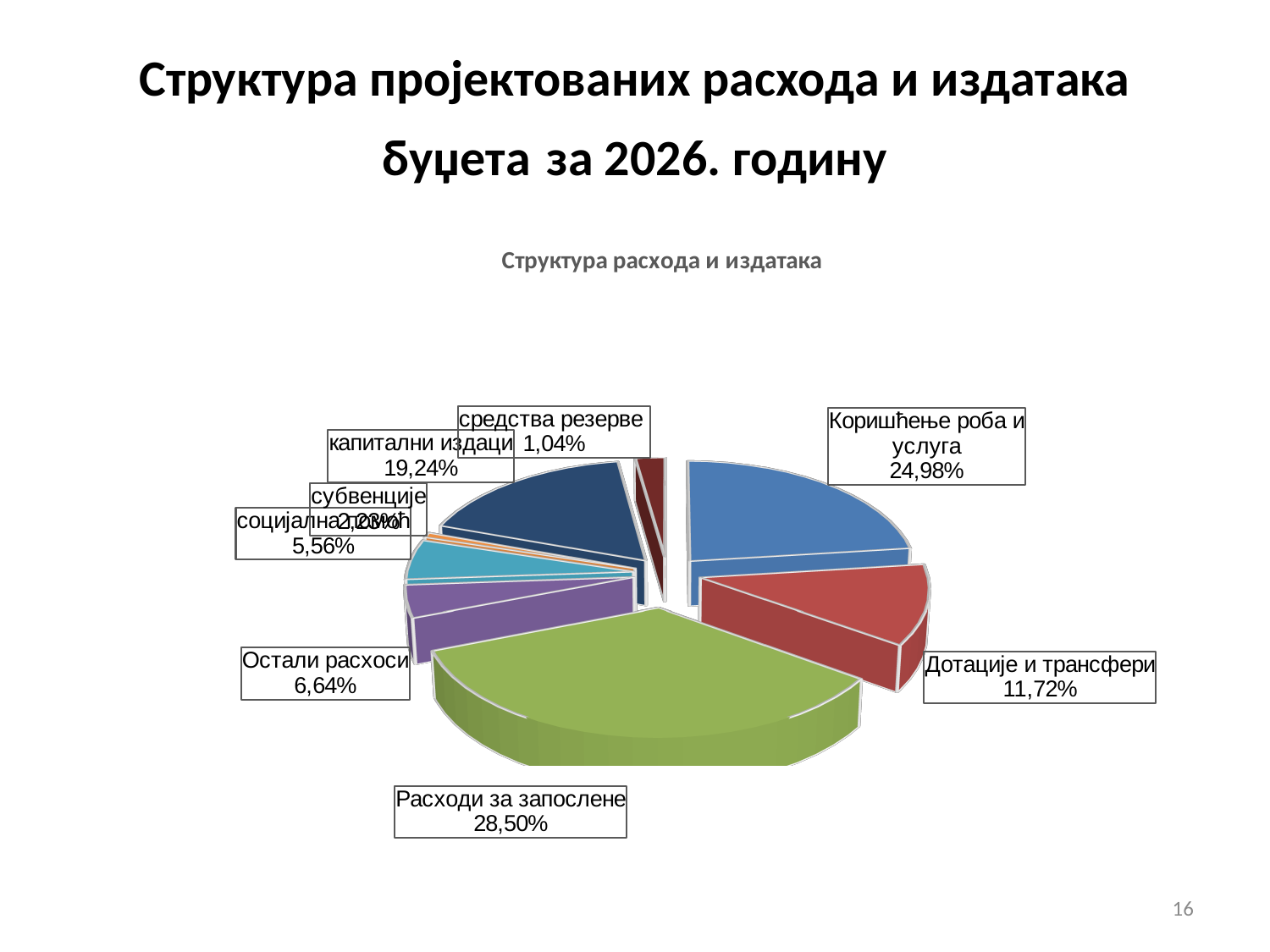
What kind of chart is shown on the slide? pie chart What share of the pie is средства резерве? 1,04% What share of the pie is Дотације и трансфери? 11,72% Which is larger, the share for Коришћење роба и услуга or the share for капитални издаци? Коришћење роба и услуга Which category has the largest share of the pie? Расходи за запослене What is the title of the chart? Структура расхода и издатака Which category has the smallest share of the pie? средства резерве What is the difference between the share for Расходи за запослене and the share for Дотације и трансфери? 16,78% What share of the pie is Расходи за запослене? 28,50% What share of the pie is Коришћење роба и услуга? 24,98% What share of the pie is капитални издаци? 19,24% What share of the pie is Остали расходи? 6,64%